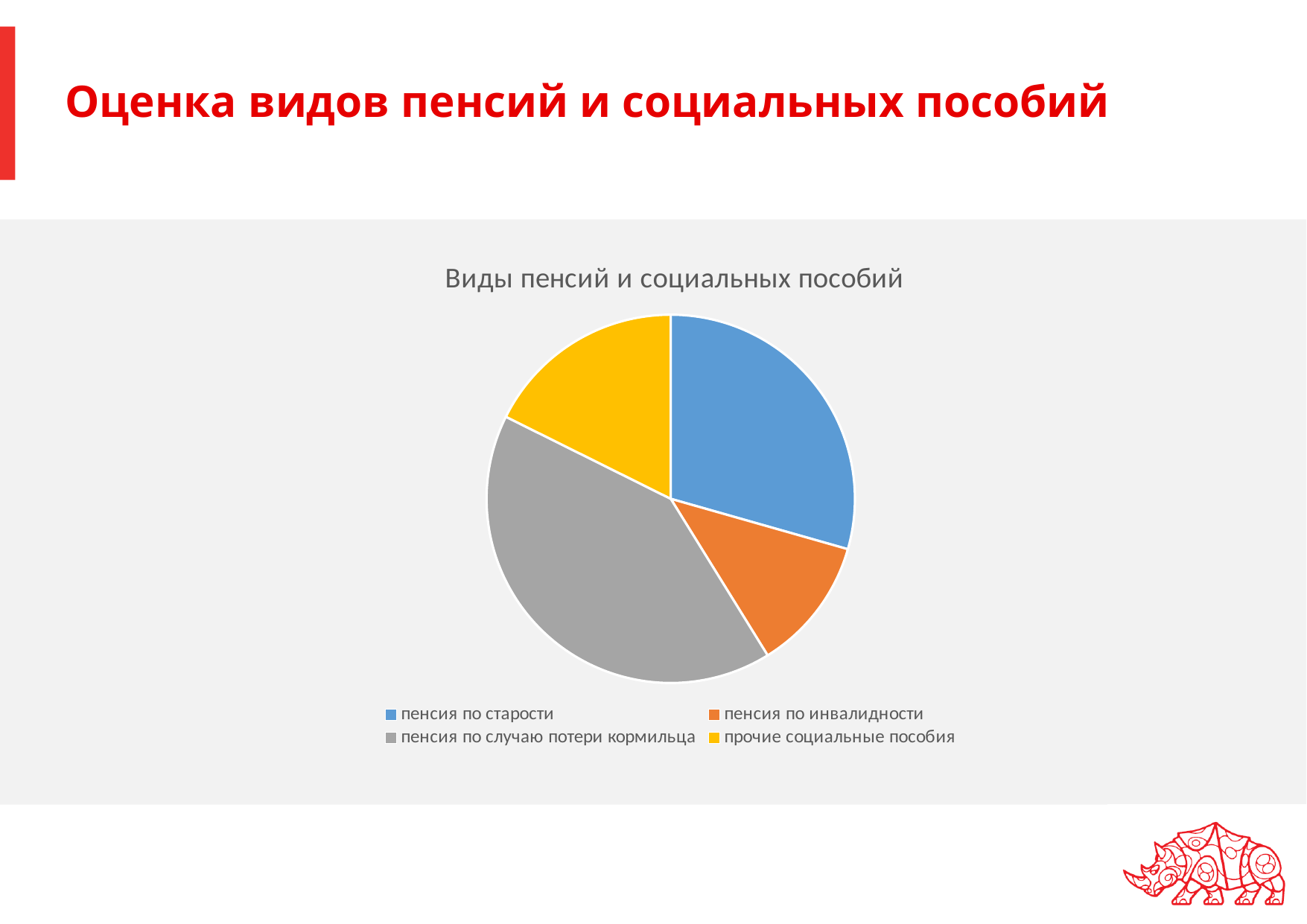
What type of chart is shown on the slide? pie chart Which slice is larger: пенсия по старости or прочие социальные пособия? пенсия по старости Which slice is larger: пенсия по инвалидности or прочие социальные пособия? прочие социальные пособия Which colour represents пенсия по случаю потери кормильца in the pie chart? gray Which category has the smallest slice of the pie? пенсия по инвалидности What is the title of the chart? Виды пенсий и социальных пособий How many entries does the legend list? 4 Which slice is larger: пенсия по старости or пенсия по случаю потери кормильца? пенсия по случаю потери кормильца Which category has the largest slice of the pie? пенсия по случаю потери кормильца How many slices does the pie chart have? 4